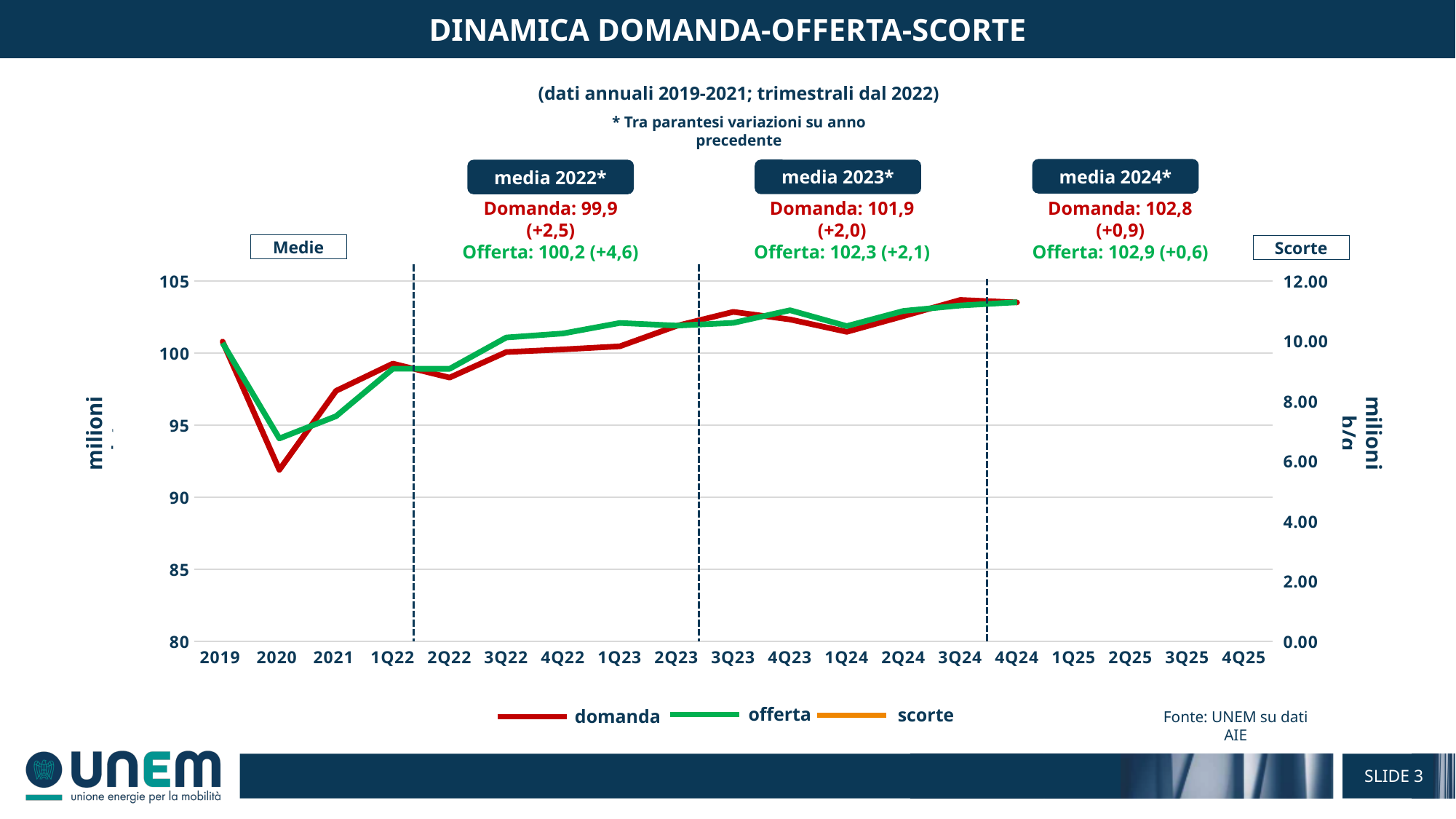
In 2021, which is larger: domanda or offerta? domanda Is the value of domanda in 2020 greater or less than 95? less In which year or quarter does the offerta line reach its lowest value? 2020 In which year or quarter does the domanda line reach its lowest value? 2020 According to the annotation, what is the media 2023 value for Domanda? 101,9 How many categories are shown on the x axis? 19 Is the value of domanda in 3Q24 greater or less than 100? greater Is the value of domanda in 2019 greater or less than 100? greater How many series does the legend list? 3 Does the domanda line generally rise or fall from 2020 to 3Q24? rise In 3Q22, which is larger: domanda or offerta? offerta What kind of chart is shown on the slide? line chart